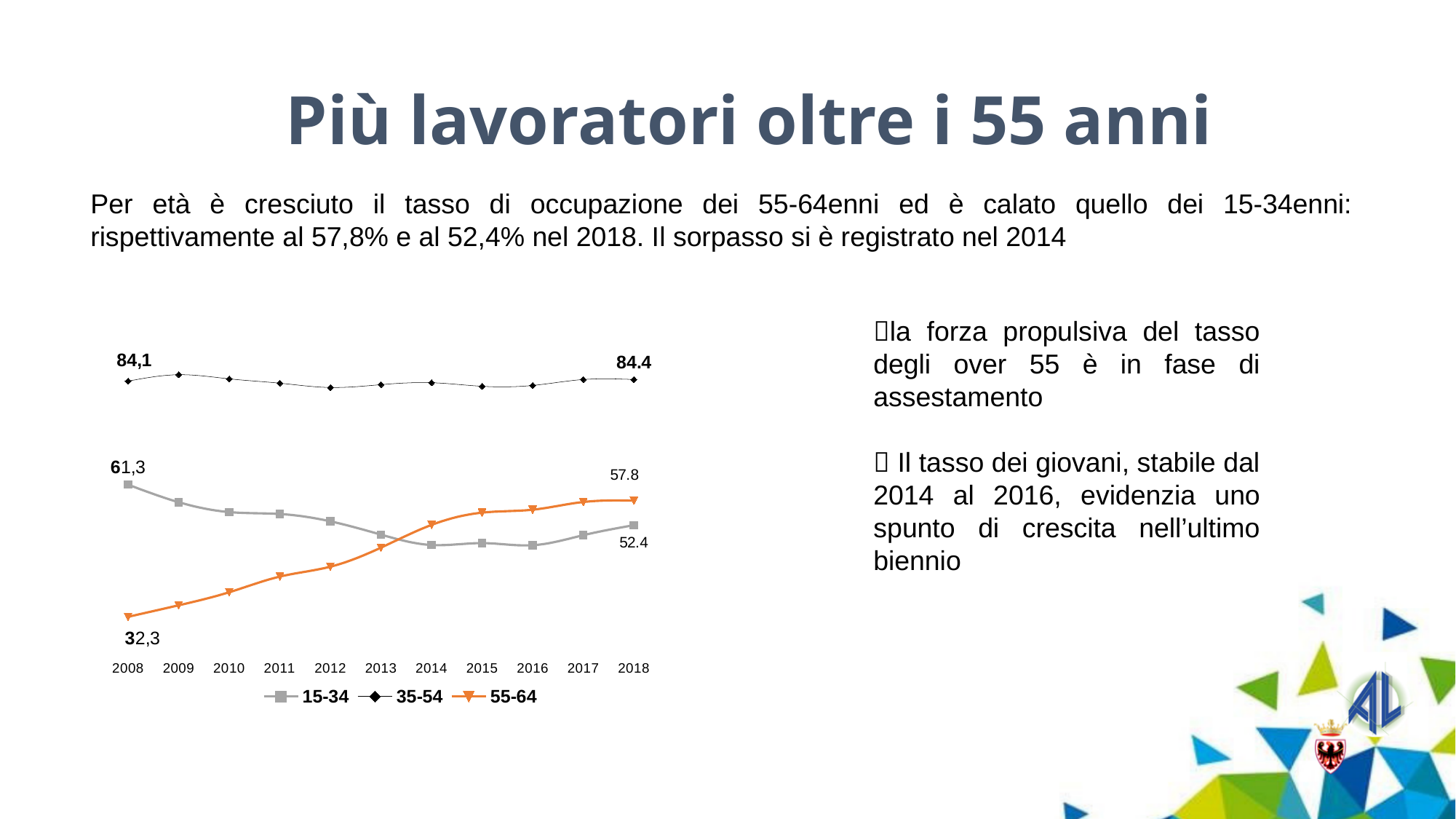
What is the value of the 15-34 series in 2018? 52.4 How many years are plotted along the x axis of the chart? 11 What is the value of the 35-54 series in 2008? 84,1 What is the value of the 55-64 series in 2008? 32,3 Which series has the highest value in 2018? 35-54 What is the value of the 55-64 series in 2018? 57.8 How many series does the chart legend list? 3 Which series has the lowest value in 2008? 55-64 What is the difference between the 55-64 value and the 15-34 value in 2018? 5.4 What is the value of the 15-34 series in 2008? 61,3 What type of chart is shown on the slide? line chart What is the value of the 35-54 series in 2018? 84.4